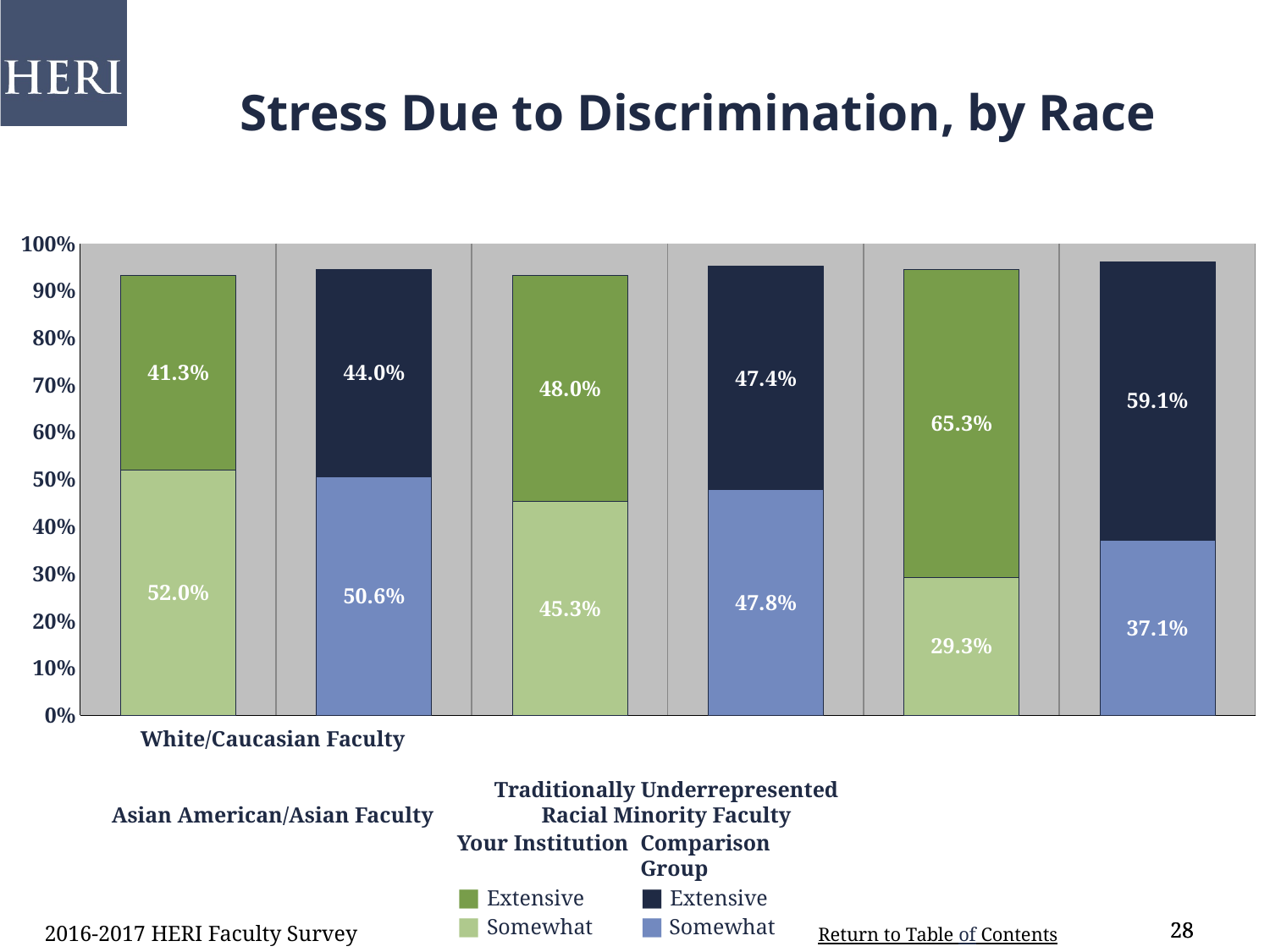
What is the difference between the Extensive values for Your Institution and the Comparison Group among Traditionally Underrepresented Racial Minority Faculty? 6.2% What kind of chart is shown on the slide? Stacked bar chart What is the total of the stacked bar for Your Institution among Traditionally Underrepresented Racial Minority Faculty? 94.6% What is the Extensive value for Your Institution among White/Caucasian Faculty? 41.3% How many race groups are shown on the x axis? 3 What is the Extensive value for the Comparison Group among Asian American/Asian Faculty? 47.4% What is the Somewhat value for the Comparison Group among Traditionally Underrepresented Racial Minority Faculty? 37.1% Among White/Caucasian Faculty, which is larger: the Somewhat value for Your Institution or for the Comparison Group? Your Institution Which race group has the highest Extensive value for Your Institution? Traditionally Underrepresented Racial Minority Faculty What is the title of the chart? Stress Due to Discrimination, by Race How many entries does the legend list? 4 Which race group has the lowest Somewhat value for Your Institution? Traditionally Underrepresented Racial Minority Faculty